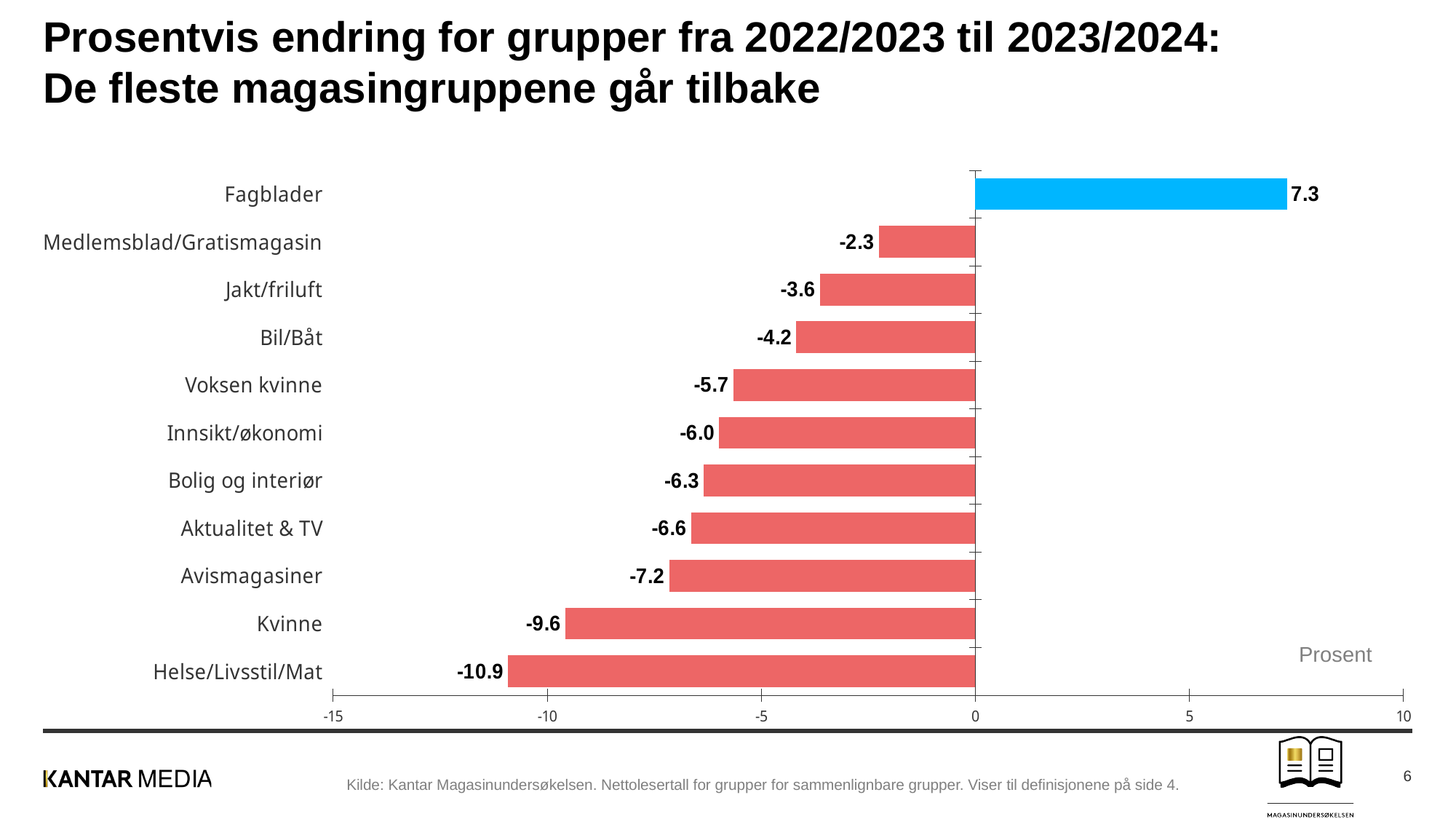
How many categories have a positive value? 1 Which has the larger value, Jakt/friluft or Bil/Båt? Jakt/friluft Is the value for Kvinne greater or less than -5? less Which category has the lowest value? Helse/Livsstil/Mat Which category has the highest value? Fagblader How many categories are shown in the chart? 11 What kind of chart is shown on the slide? bar chart What is the value for Helse/Livsstil/Mat? -10.9 What is the value for Avismagasiner? -7.2 What is the difference between the values for Kvinne and Avismagasiner? 2.4 What is the value for Voksen kvinne? -5.7 What is the value for Fagblader? 7.3